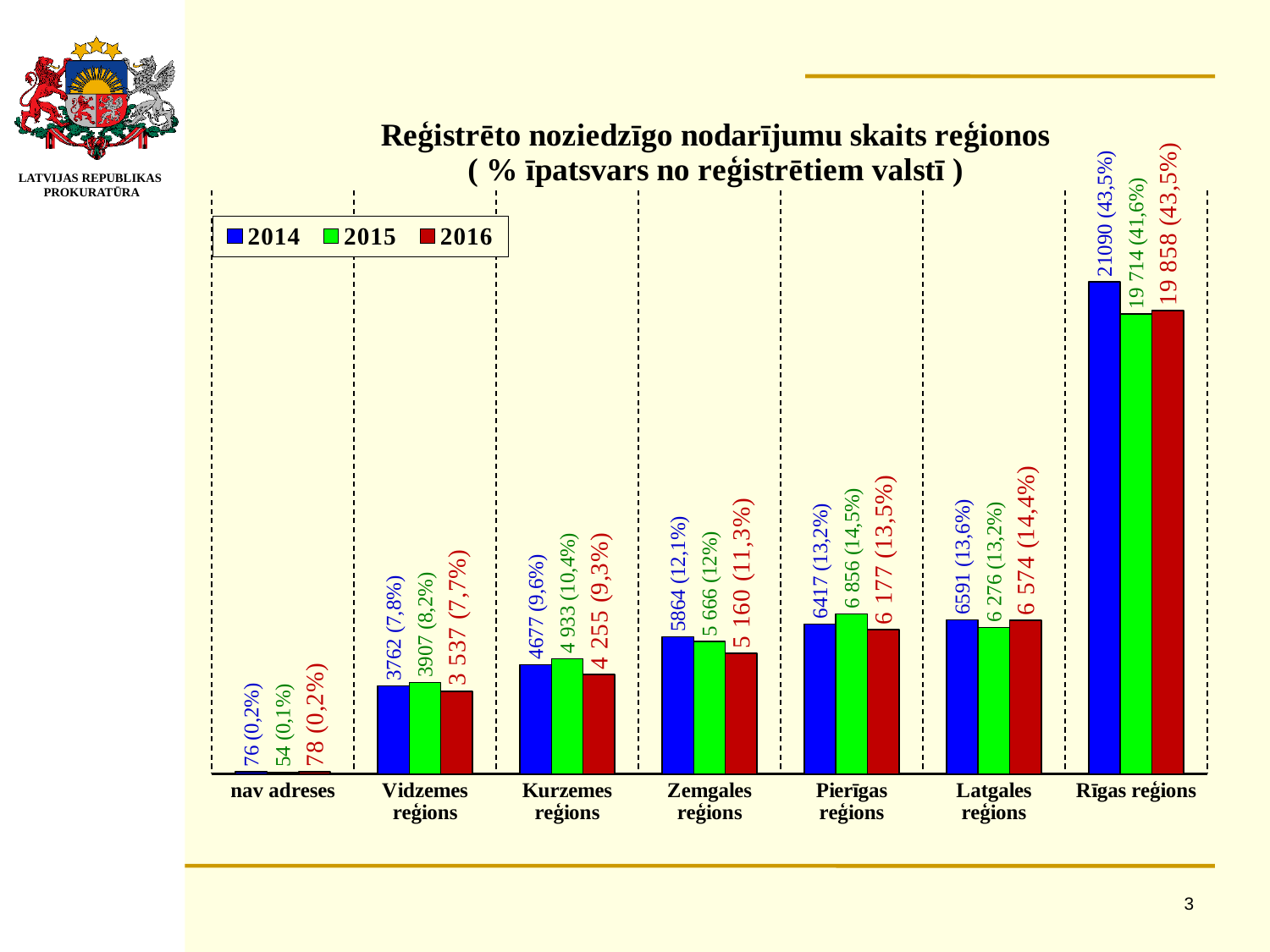
Which is larger for Latgales reģions: the 2015 value or the 2016 value? 2016 Which category has the lowest value in 2016? nav adreses How many regions (categories) are shown on the x axis? 7 Which region has the highest value in 2014? Rīgas reģions What is the 2014 value for Kurzemes reģions? 4677 (9,6%) What is the difference between the 2014 and 2015 counts for Rīgas reģions? 1376 Which years are listed in the legend? 2014, 2015, 2016 What is the 2015 value for Pierīgas reģions? 6 856 (14,5%) What is the 2016 value for Rīgas reģions? 19 858 (43,5%) How many series does the legend list? 3 What is the 2015 value for nav adreses? 54 (0,1%) What kind of chart is shown on the slide? bar chart